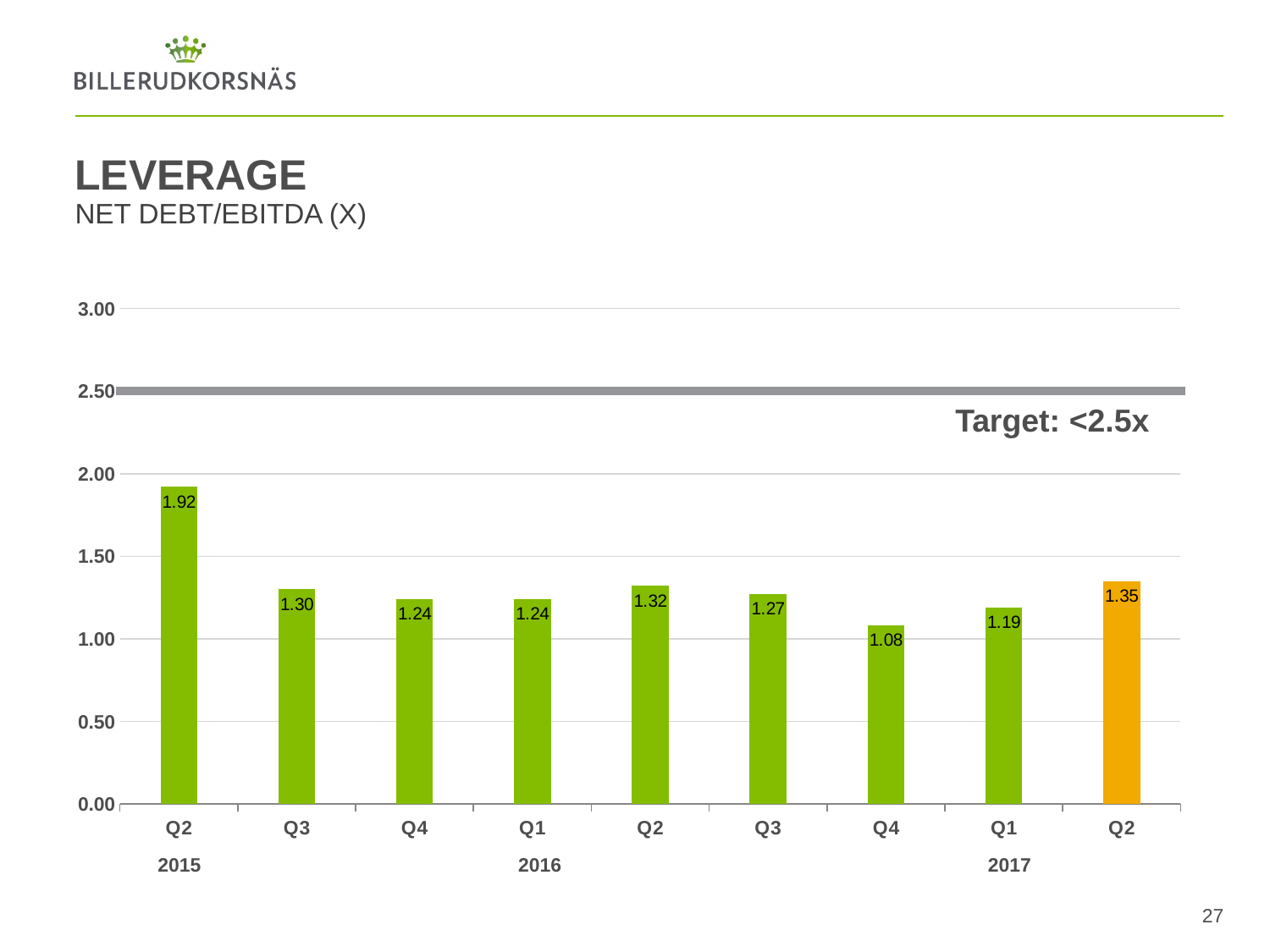
What is the net debt/EBITDA value for Q4 2016? 1.08 What is the difference between the net debt/EBITDA values for Q2 2015 and Q2 2017? 0.57 What kind of chart is shown on the slide? bar chart How many quarters are plotted on the chart? 9 Which quarter has the lowest net debt/EBITDA value? Q4 2016 Which bar is coloured orange instead of green? Q2 2017 Is the value for Q2 2015 greater or less than 2.50? less What is the net debt/EBITDA value for Q2 2017? 1.35 Which quarter has the highest net debt/EBITDA value? Q2 2015 What is the net debt/EBITDA value for Q2 2015? 1.92 What target is stated on the chart? <2.5x Which is larger, the value for Q1 2017 or the value for Q2 2017? Q2 2017